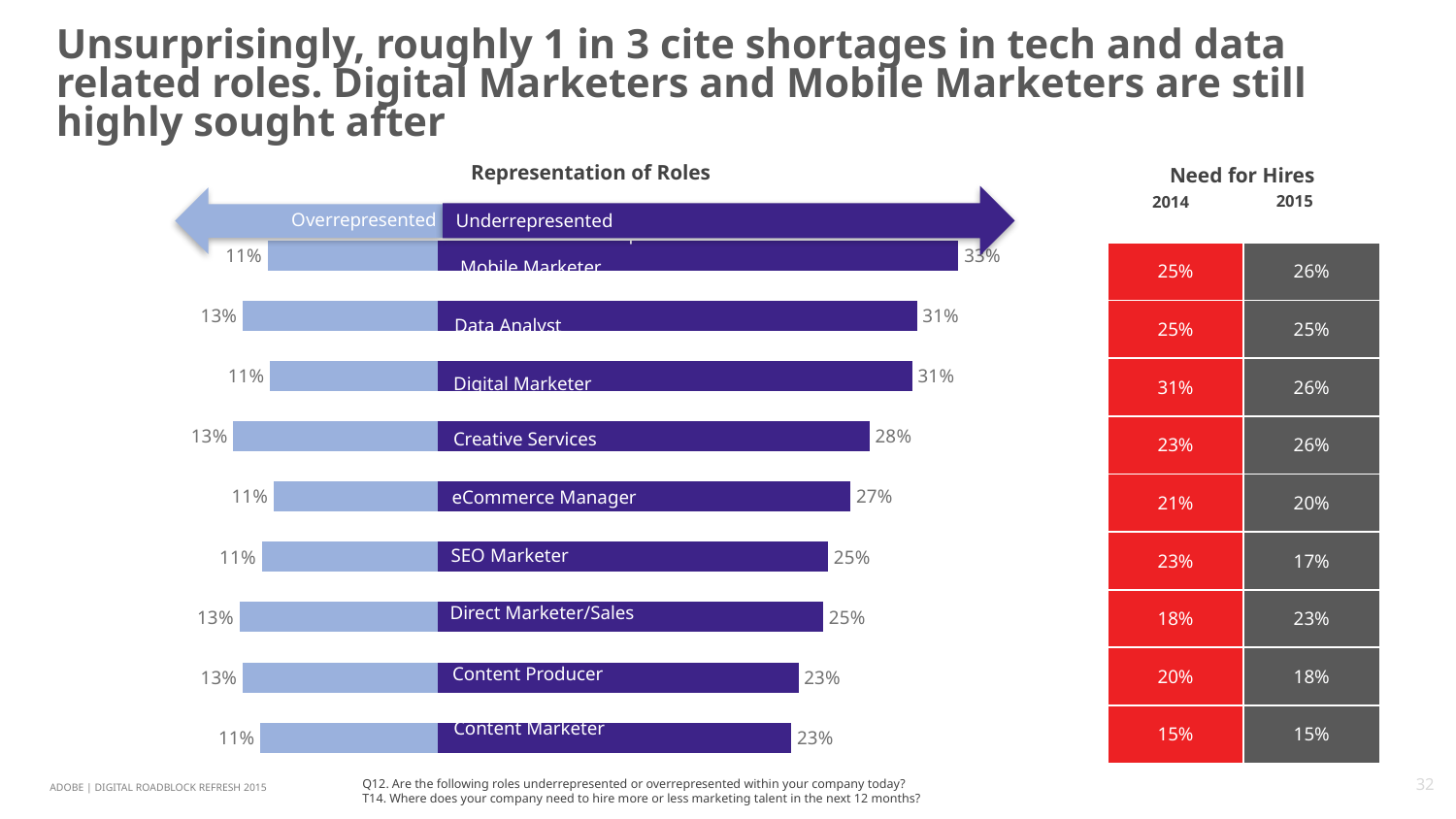
How many series does the Representation of Roles chart show? 2 What are the two series labels shown in the Representation of Roles chart? Overrepresented and Underrepresented What is the difference between the Underrepresented values for Mobile Marketer and Content Marketer in the Representation of Roles chart? 10 percentage points Which role has the highest Underrepresented value in the Representation of Roles chart? Mobile Marketer What type of chart is the Representation of Roles chart? Bar chart In the Representation of Roles chart, which has the larger Overrepresented value: Content Producer or Content Marketer? Content Producer What is the Underrepresented value for eCommerce Manager in the Representation of Roles chart? 27% How many roles are shown in the Representation of Roles chart? 9 What is the Underrepresented value for Mobile Marketer in the Representation of Roles chart? 33% In the Representation of Roles chart, which has the larger Underrepresented value: Data Analyst or SEO Marketer? Data Analyst What is the Underrepresented value for Creative Services in the Representation of Roles chart? 28% What is the Overrepresented value for Data Analyst in the Representation of Roles chart? 13%